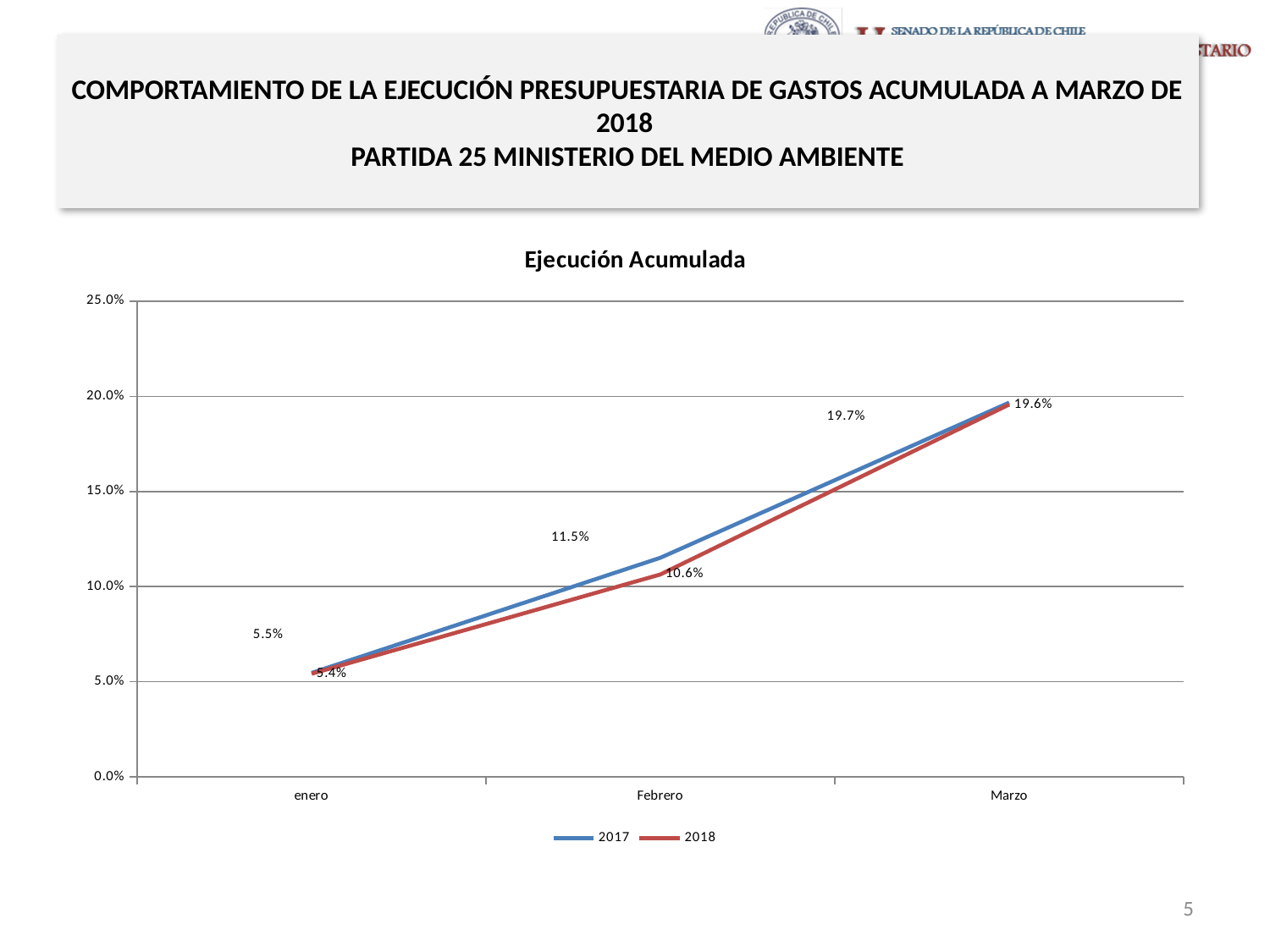
What is the value for 2018 in enero? 5.4% How many months are shown on the x axis? 3 What is the value for 2017 in Febrero? 11.5% What kind of chart is shown on the slide? line chart Which series has the larger value in Febrero, 2017 or 2018? 2017 Do the values for 2017 rise or fall from enero to Marzo? rise What is the title of the chart? Ejecución Acumulada What is the value for 2017 in Marzo? 19.7% In which month is the 2018 series highest? Marzo What is the value for 2018 in Febrero? 10.6% What is the difference between the 2017 and 2018 values in Febrero? 0.9% How many series does the legend list? 2